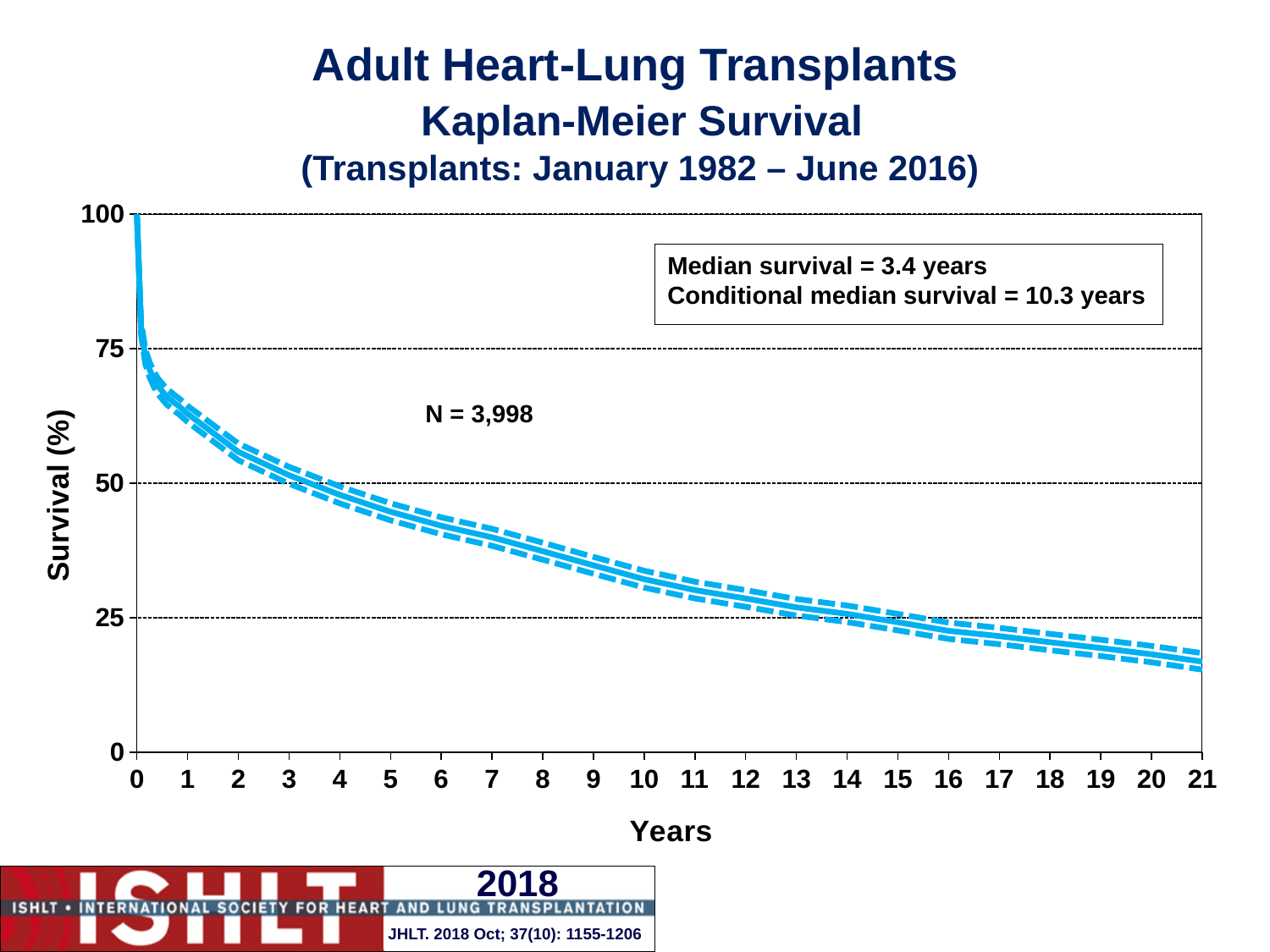
Does survival rise or fall as the years increase along the x axis? fall What is the survival value at 0 years? 100 Is the survival value at 10 years greater or less than 25? greater What is the median survival stated on the chart? 3.4 years Is the survival value at 20 years greater or less than 25? less Is the survival value at 1 year greater or less than 75? less What is the N value shown on the chart? N = 3,998 What is the conditional median survival stated on the chart? 10.3 years What is the label of the y axis? Survival (%) What kind of chart is shown on the slide? line chart